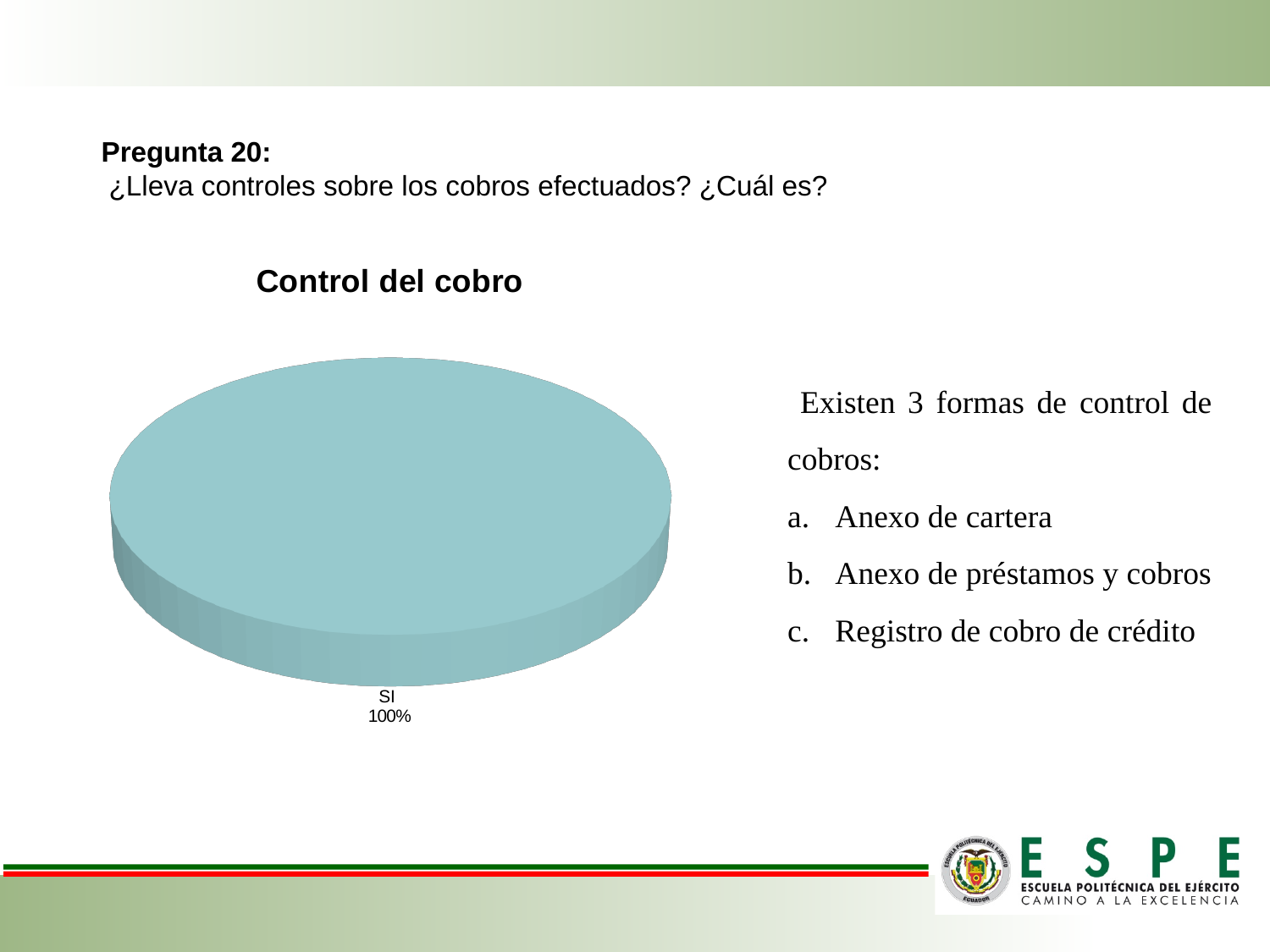
What kind of chart is shown on the slide? pie chart How many slices does the pie chart have? 1 Which category is the largest slice of the pie? SI What is the label of the only slice in the pie chart? SI What is the title of the chart? Control del cobro What is the value shown for the SI category? 100% What share of the pie does the SI slice represent? 100% Is the value for SI greater or less than 50%? greater